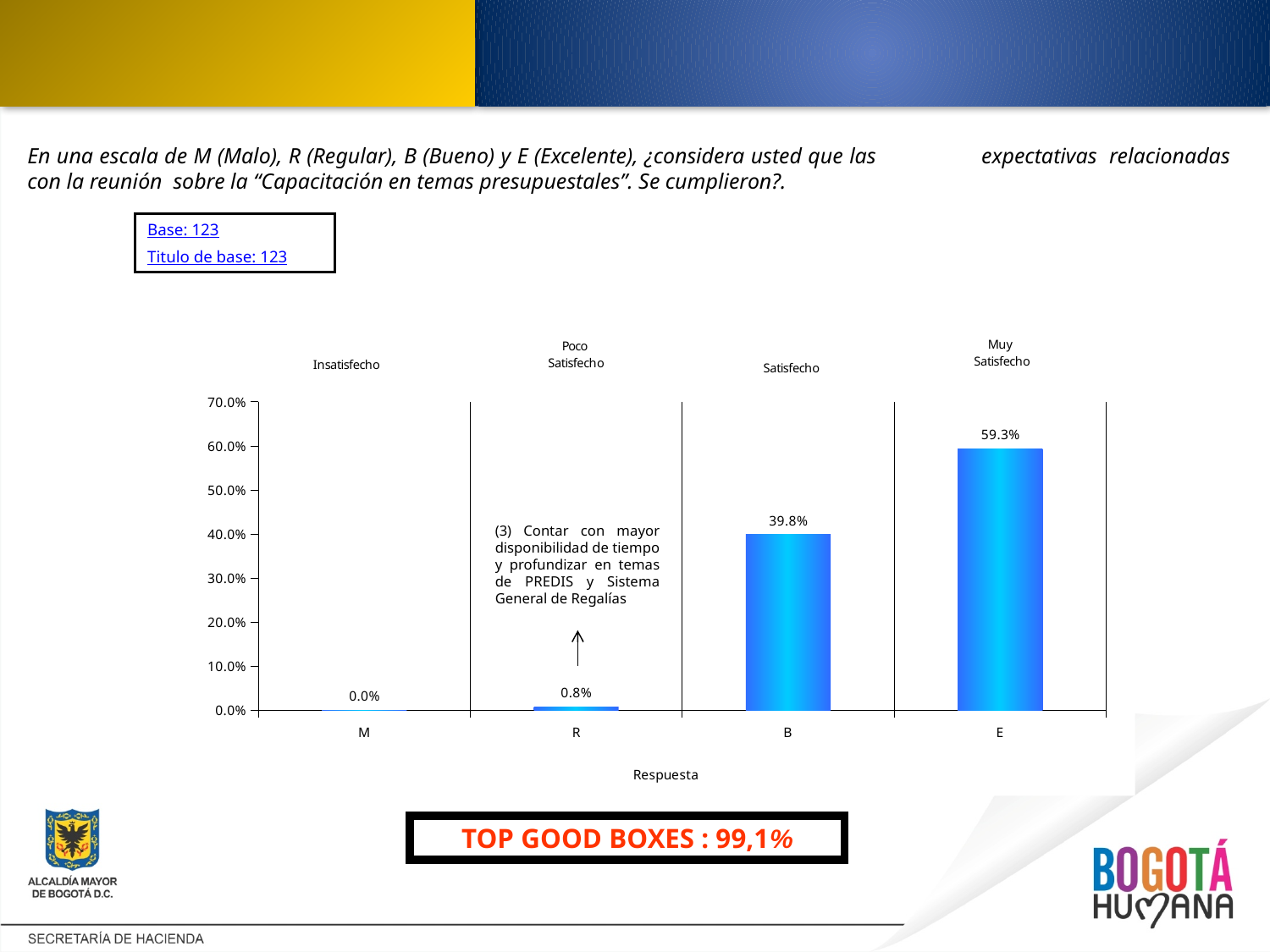
How many categories are shown on the x axis? 4 Which is larger, the value for B or the value for R? B Is the value for E greater or less than 50.0%? greater What is the label of the x axis? Respuesta What is the value for category R? 0.8% Which category has the lowest value? M What is the value for category E? 59.3% Which category has the highest value? E What is the value for category M? 0.0% What kind of chart is shown? bar chart What is the difference between the values for E and B? 19.5% What is the value for category B? 39.8%